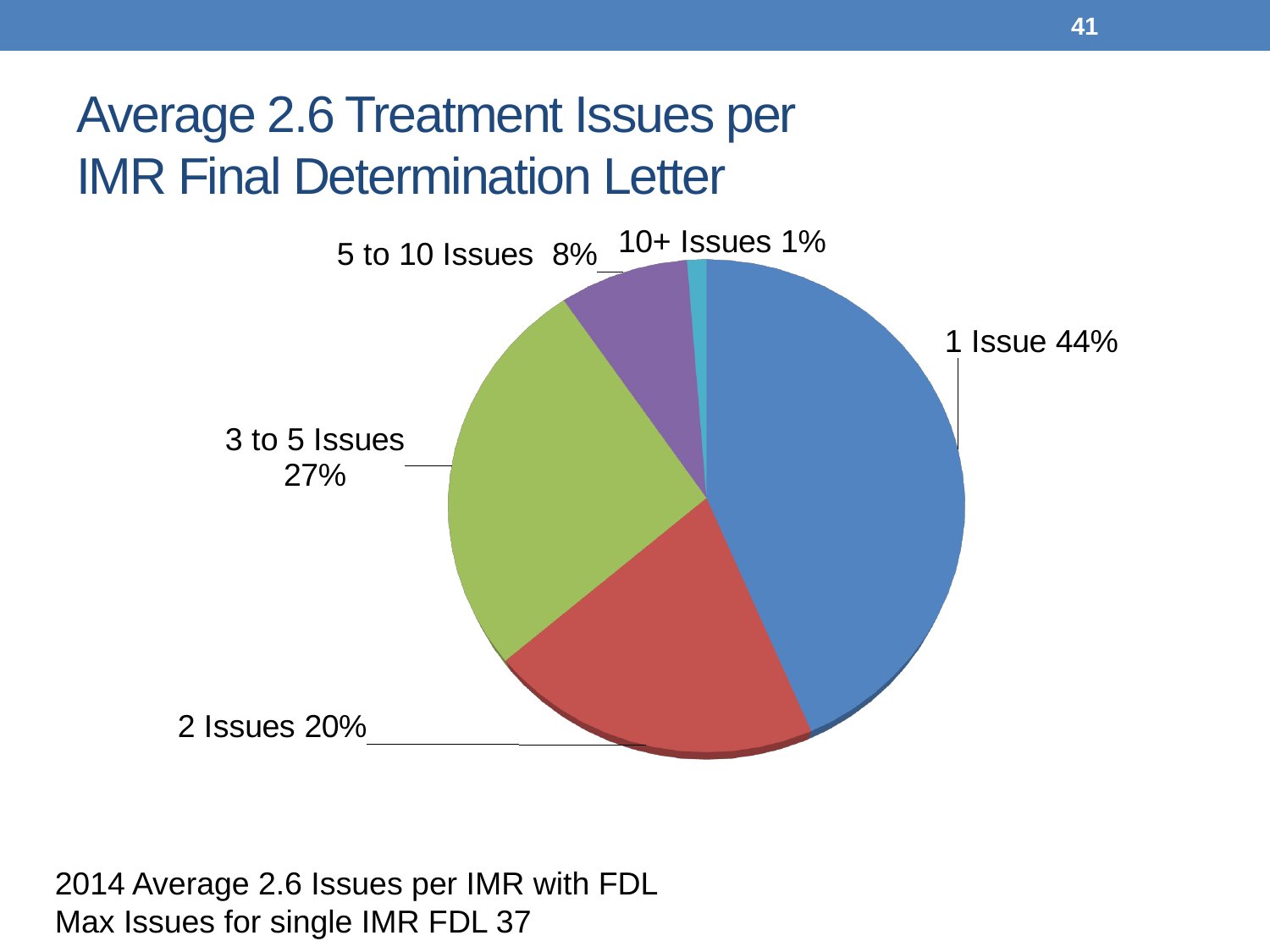
What is the difference in percentage points between the "1 Issue" slice and the "3 to 5 Issues" slice? 17 What share of the pie is labelled "2 Issues"? 20% What share of the pie is labelled "3 to 5 Issues"? 27% What share of the pie is labelled "10+ Issues"? 1% Which slice of the pie is the smallest? 10+ Issues What colour is the "1 Issue" slice? blue What kind of chart is shown on the slide? pie chart Which is larger, the "2 Issues" slice or the "3 to 5 Issues" slice? 3 to 5 Issues How many slices does the pie chart have? 5 Which slice of the pie is the largest? 1 Issue